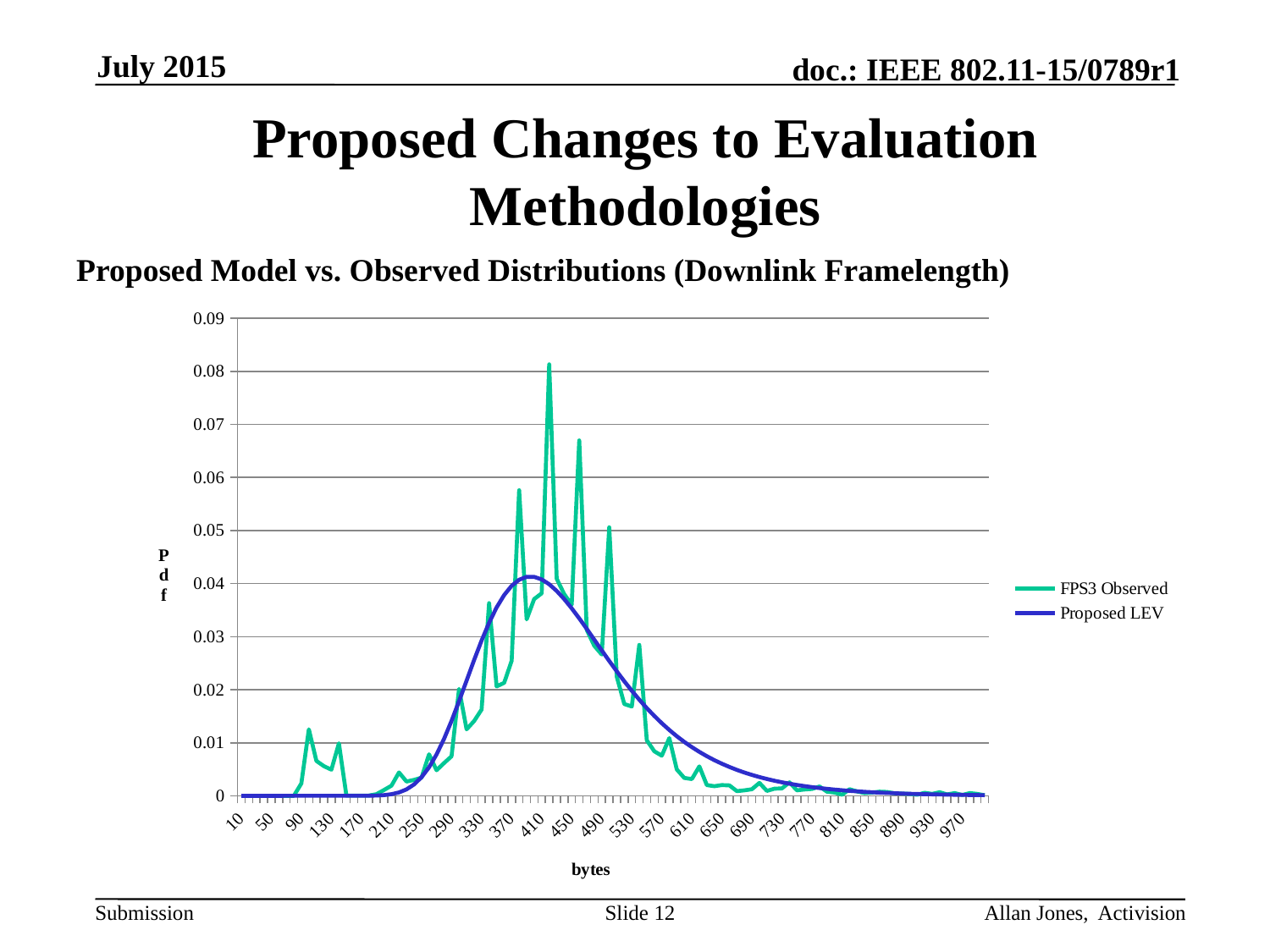
What are the two series named in the legend? FPS3 Observed and Proposed LEV What kind of chart is shown on the slide? line chart Is the highest value of the Proposed LEV series greater or less than 0.03? greater How many series does the legend list? 2 Is the value of the Proposed LEV series at 170 bytes greater or less than 0.01? less Does the Proposed LEV line rise or fall along the x axis between 250 and 370 bytes? rise Does the Proposed LEV line rise or fall along the x axis between 450 and 970 bytes? fall Is the highest value of the FPS3 Observed series greater or less than 0.07? greater Which series reaches the higher peak value, FPS3 Observed or Proposed LEV? FPS3 Observed What is the label of the x axis? bytes